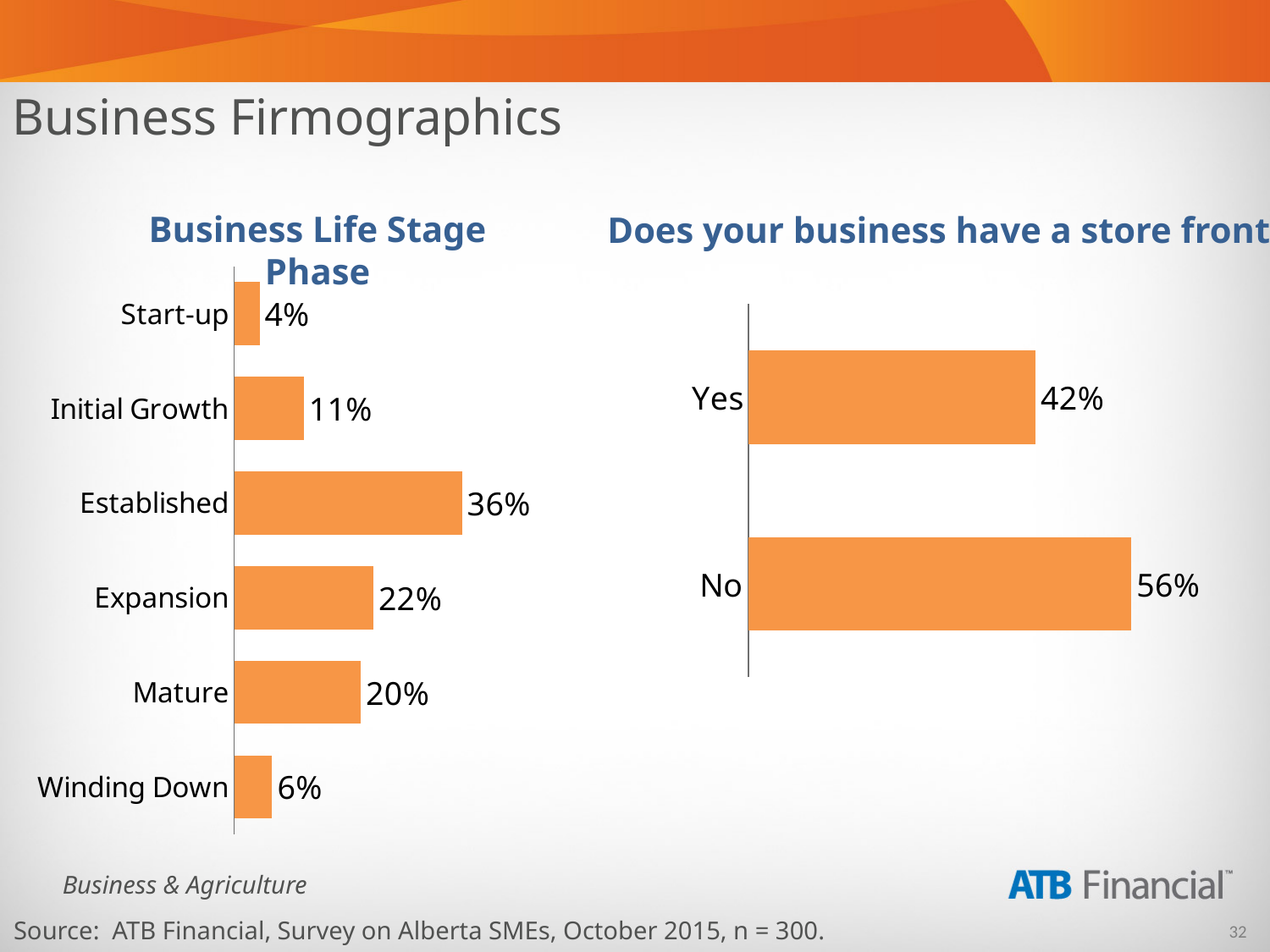
In the Business Life Stage Phase chart, which category has the highest value? Established How many categories are shown in the Business Life Stage Phase chart? 6 In the Business Life Stage Phase chart, what is the value for Initial Growth? 11% In the Business Life Stage Phase chart, what is the value for Established? 36% In the Business Life Stage Phase chart, what is the difference between Expansion and Mature? 2% In the 'Does your business have a store front' chart, what is the difference between No and Yes? 14% In the Business Life Stage Phase chart, which category has the lowest value? Start-up In the Business Life Stage Phase chart, which is larger, Winding Down or Start-up? Winding Down What kind of chart is the Business Life Stage Phase chart? Bar chart In the 'Does your business have a store front' chart, what is the value for Yes? 42% In the 'Does your business have a store front' chart, what is the value for No? 56% How many categories are shown in the 'Does your business have a store front' chart? 2